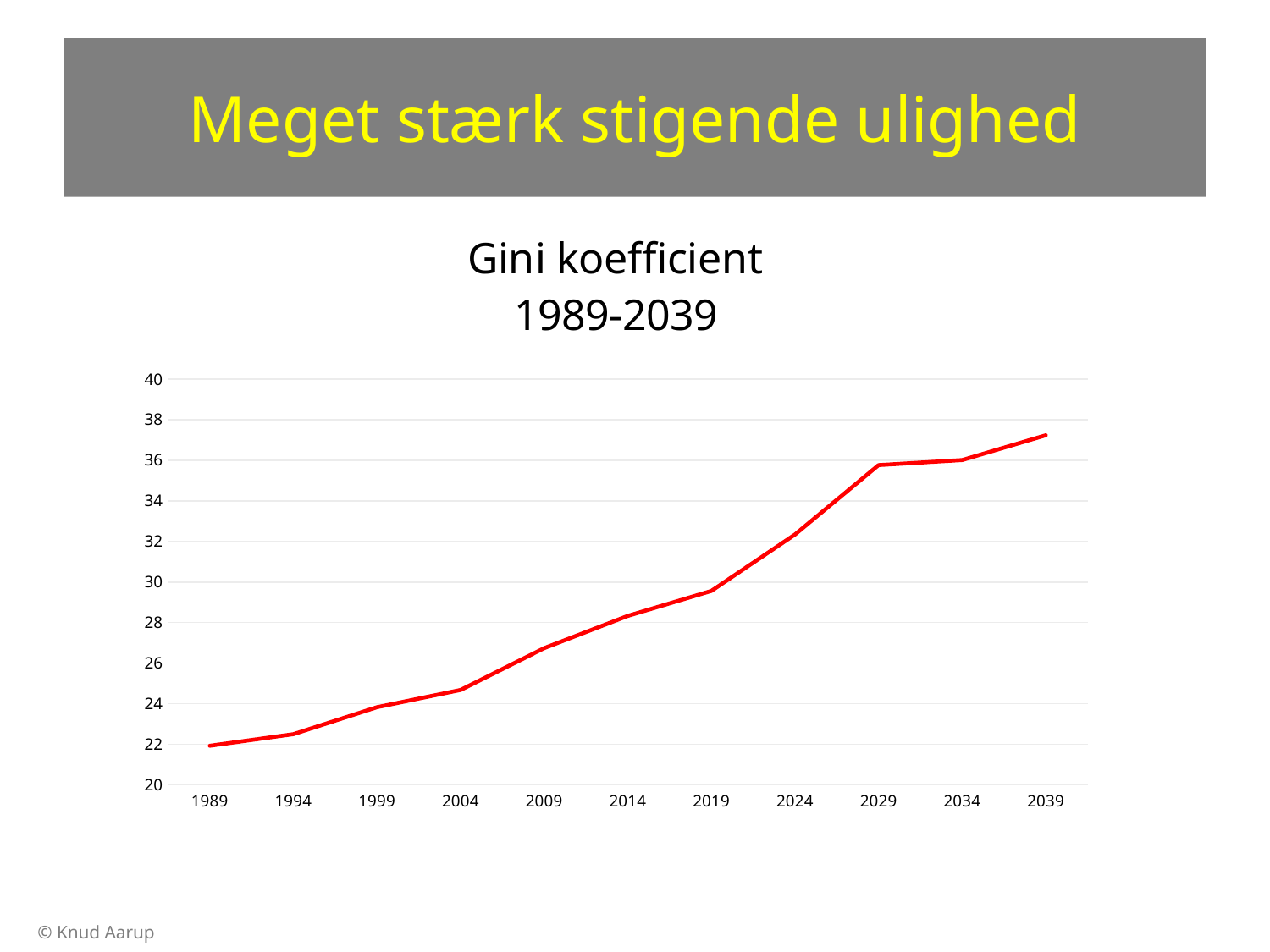
Which year has the larger value, 2004 or 2024? 2024 What kind of chart is shown on the slide? line chart Which year has the lowest Gini coefficient in the chart? 1989 What is the title of the chart? Gini koefficient 1989-2039 Is the value for 2014 greater or less than 30? less How many years are labelled on the x axis of the chart? 11 Which year has the highest Gini coefficient in the chart? 2039 Is the value for 1989 greater or less than 24? less Do the values in the chart rise or fall from 1989 to 2039? rise Is the value for 2009 greater or less than 26? greater What colour is the line in the chart? red